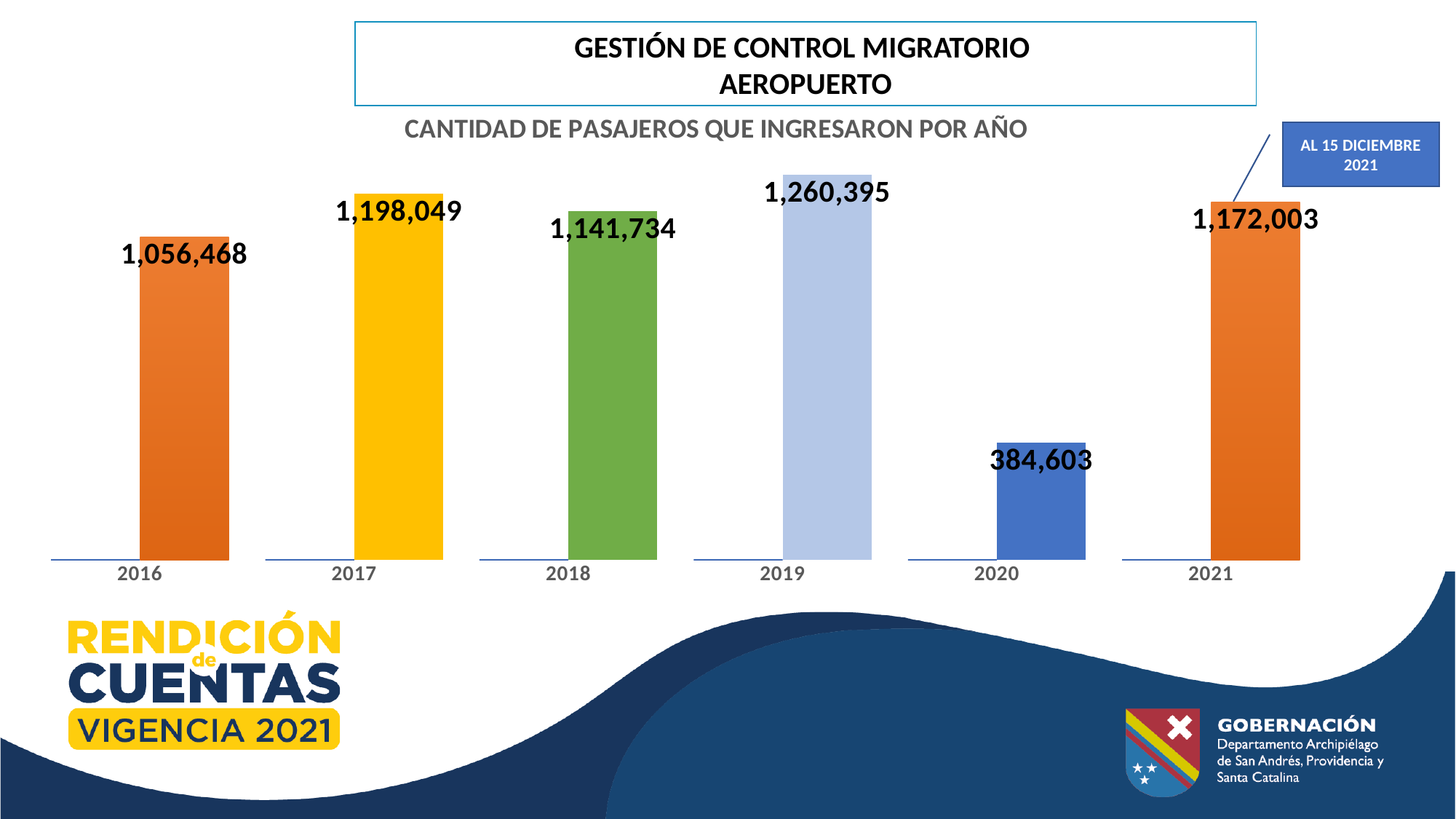
What is the value for 2020? 384,603 How many years are shown on the x axis? 6 What is the value for 2021? 1,172,003 What is the value for 2016? 1,056,468 What is the difference between the values for 2019 and 2020? 875,792 What kind of chart is this? Bar chart Which year has the highest value? 2019 Which is larger, the value for 2017 or the value for 2018? 2017 Which year has the lowest value? 2020 What is the chart's subtitle above the bars? CANTIDAD DE PASAJEROS QUE INGRESARON POR AÑO What is the difference between the values for 2017 and 2016? 141,581 Does the value rise or fall from 2019 to 2020? Fall